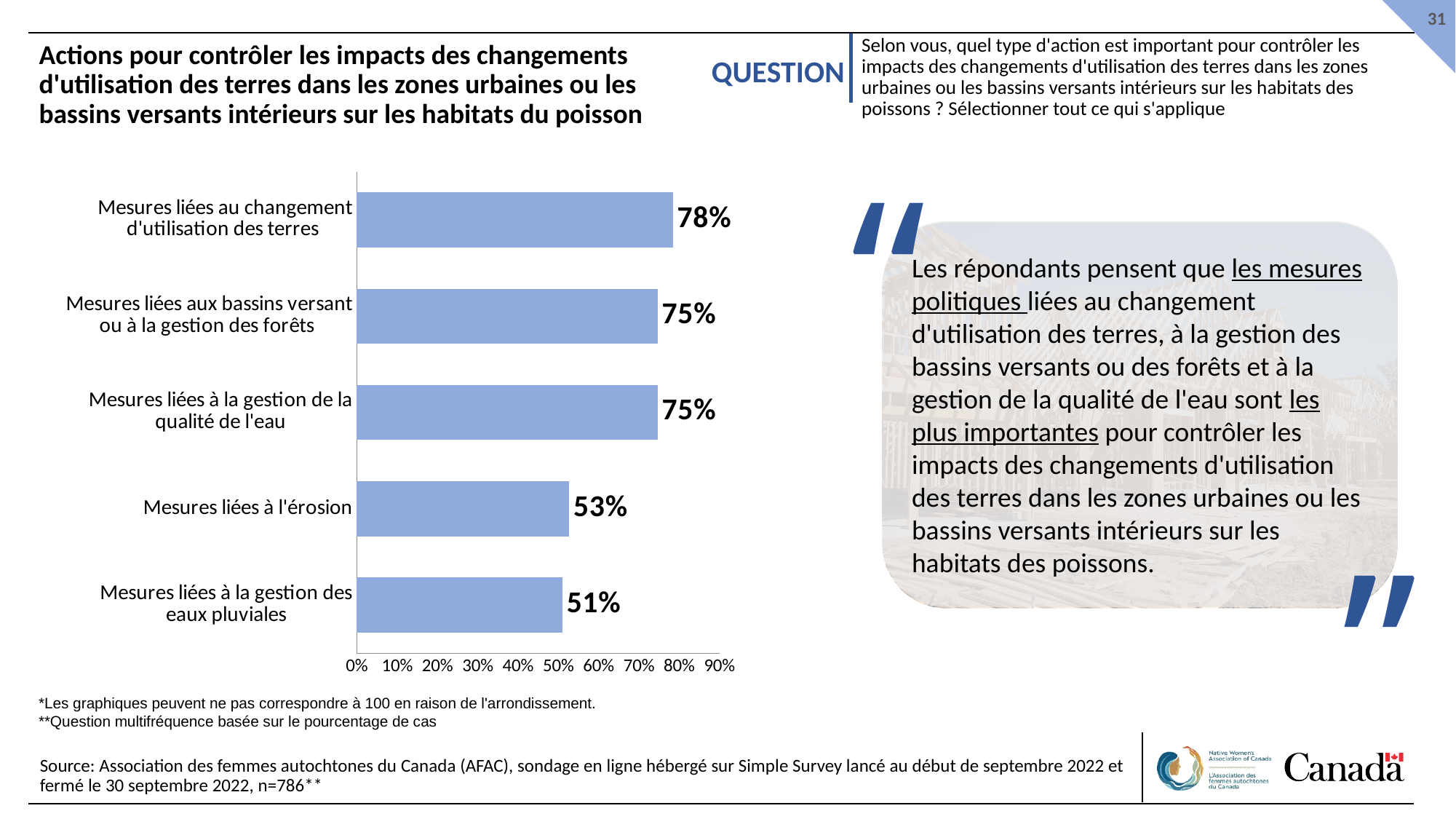
What kind of chart is shown on the slide? Bar chart Which is larger: the value for "Mesures liées à la gestion de la qualité de l'eau" or the value for "Mesures liées à la gestion des eaux pluviales"? Mesures liées à la gestion de la qualité de l'eau How many categories are shown in the chart? 5 How many categories share the value 75%? 2 Is the value for "Mesures liées aux bassins versant ou à la gestion des forêts" greater or less than 60%? greater What is the value shown for "Mesures liées à l'érosion"? 53% What percentage of respondents selected "Mesures liées au changement d'utilisation des terres"? 78% What is the value shown for "Mesures liées à la gestion des eaux pluviales"? 51% What is the difference between the values for "Mesures liées au changement d'utilisation des terres" and "Mesures liées à l'érosion"? 25% What is the highest value shown on the x axis of the chart? 90% Which category has the highest value in the chart? Mesures liées au changement d'utilisation des terres Which category has the lowest value in the chart? Mesures liées à la gestion des eaux pluviales